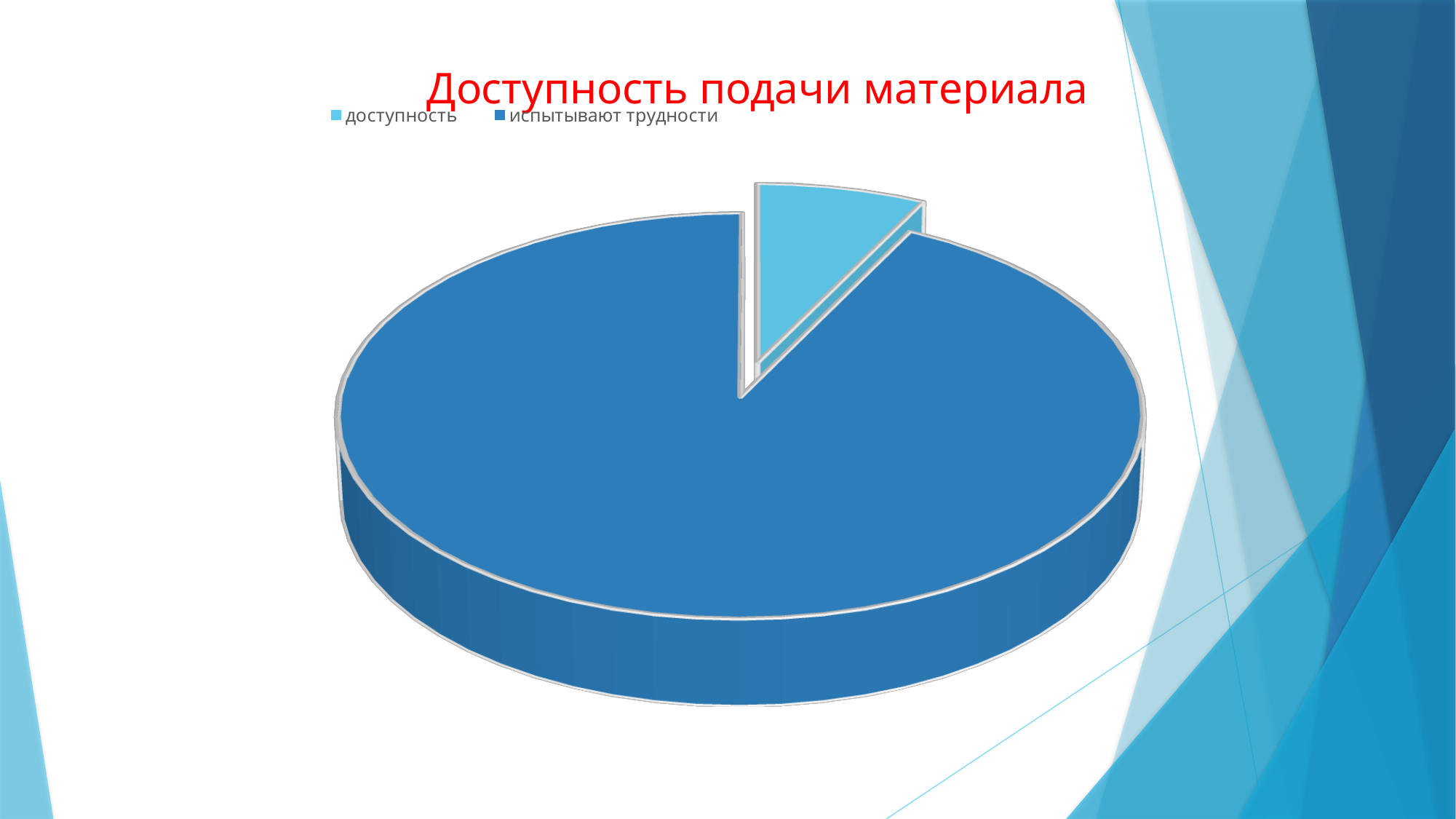
How many entries does the chart legend list? 2 Which legend entry is shown in the lighter blue colour? доступность What is the title of the chart? Доступность подачи материала How many slices does the pie chart have? 2 Which category has the smallest slice of the pie? доступность Which category has the largest slice of the pie? испытывают трудности What kind of chart is shown on the slide? pie chart Which slice is larger: доступность or испытывают трудности? испытывают трудности